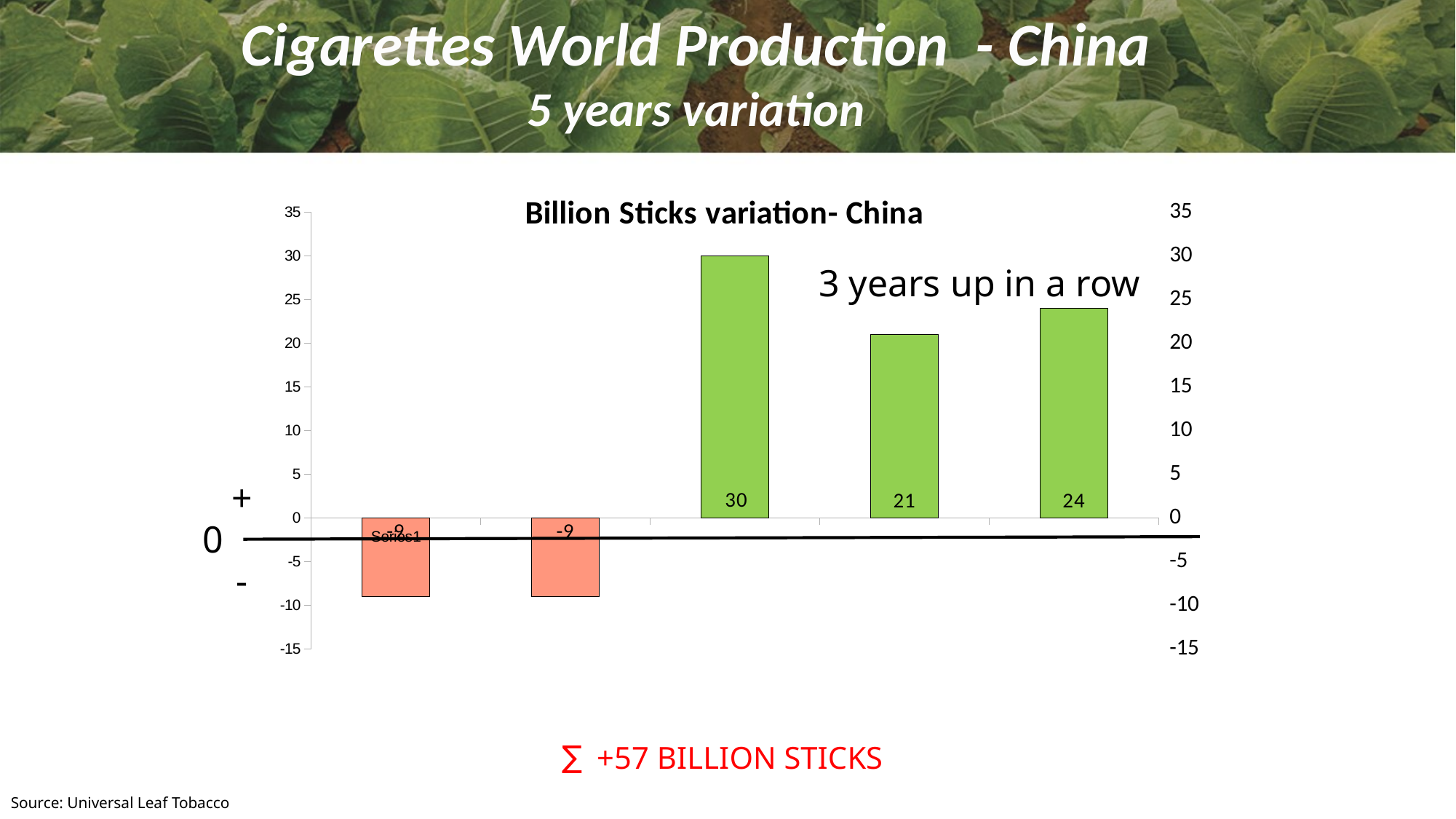
What is the title of the chart? Billion Sticks variation- China What is the value of the rightmost bar? 24 How many bars are plotted in the chart? 5 Which is larger, the fourth bar or the fifth bar? the fifth bar (24) What is the value of the second bar from the left? -9 What kind of chart is shown on the slide? bar chart What is the difference between the third bar (30) and the fourth bar (21)? 9 What is the value of the third bar from the left? 30 What total is stated below the chart for the five-year variation? +57 BILLION STICKS How many bars have negative values? 2 What is the value of the fourth bar from the left? 21 Which bar has the highest value? the third bar (30)